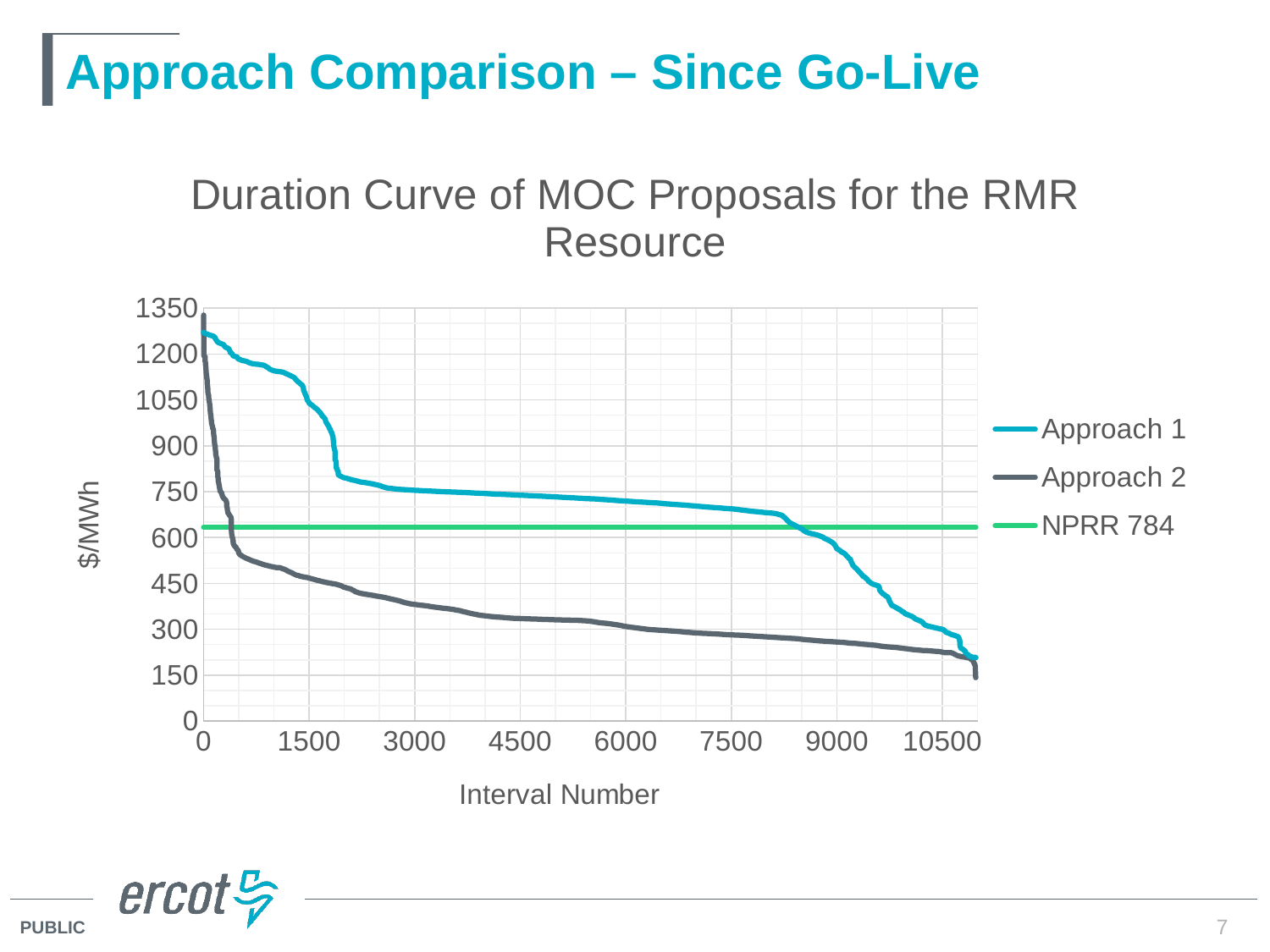
Does the Approach 1 line rise or fall as the interval number increases? Fall What kind of chart is shown on the slide? Line chart How many series does the legend list? 3 What are the series names listed in the legend? Approach 1, Approach 2, NPRR 784 What is the title of the chart? Duration Curve of MOC Proposals for the RMR Resource Is the value of Approach 2 at interval number 4500 greater or less than 450 $/MWh? less Is the value of Approach 1 at interval number 4500 greater or less than 600 $/MWh? greater At interval number 9000, which series has the higher value, Approach 1 or Approach 2? Approach 1 Does the NPRR 784 line rise, fall, or stay flat across the interval numbers? Stay flat Is the value of the NPRR 784 line greater or less than 750 $/MWh? less Does the Approach 2 line rise or fall as the interval number increases? Fall At interval number 3000, which series has the higher value, Approach 1 or Approach 2? Approach 1